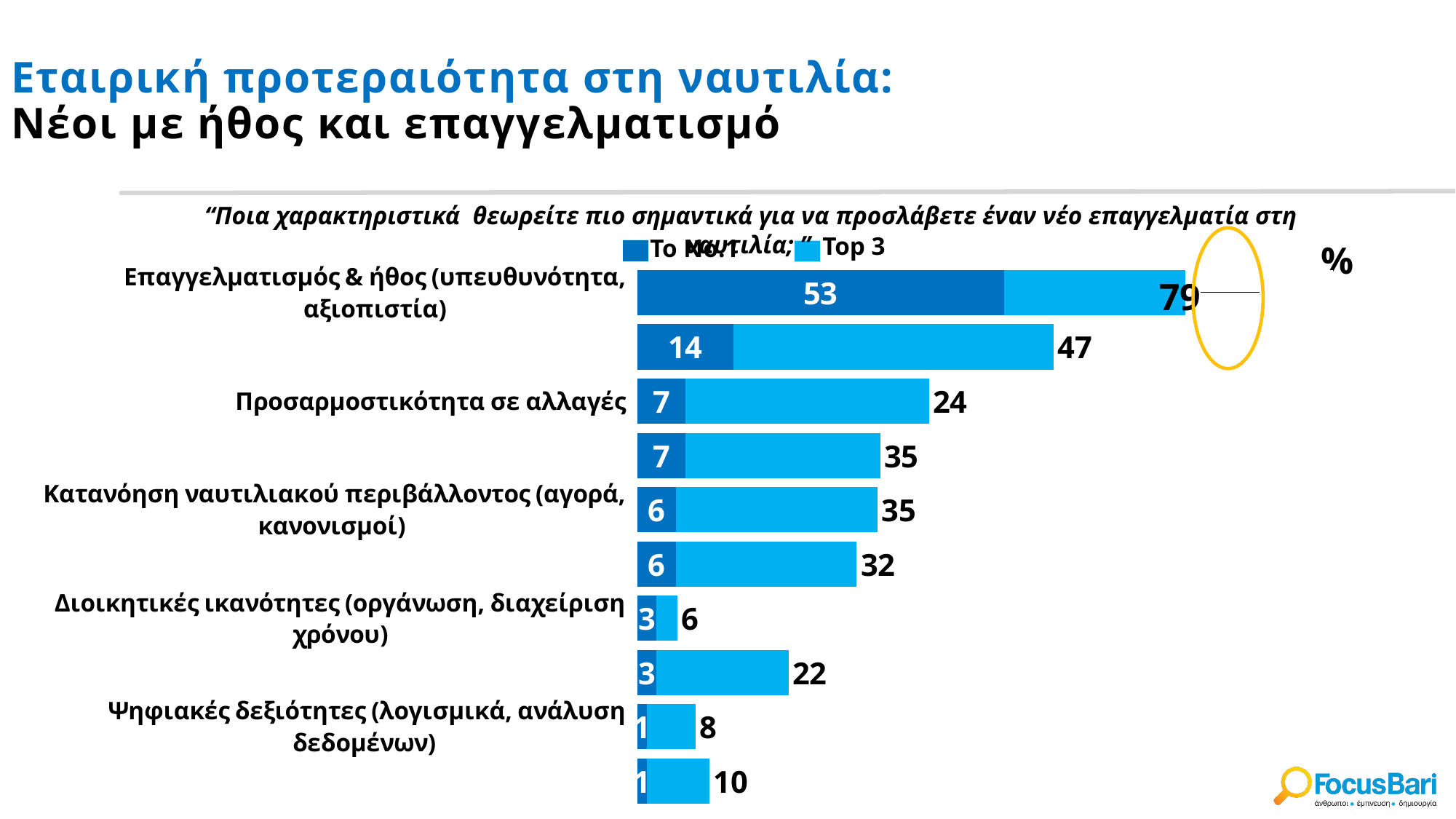
What is the difference between the Top 3 value and the "Το No.1" value for "Επαγγελματισμός & ήθος (υπευθυνότητα, αξιοπιστία)"? 26 What is the Top 3 value for "Προσαρμοστικότητα σε αλλαγές"? 24 Which has a larger Top 3 value: "Προσαρμοστικότητα σε αλλαγές" or "Κατανόηση ναυτιλιακού περιβάλλοντος (αγορά, κανονισμοί)"? Κατανόηση ναυτιλιακού περιβάλλοντος (αγορά, κανονισμοί) What is the "Το No.1" value for "Επαγγελματισμός & ήθος (υπευθυνότητα, αξιοπιστία)"? 53 Which category has the highest Top 3 value? Επαγγελματισμός & ήθος (υπευθυνότητα, αξιοπιστία) What is the "Το No.1" value for "Κατανόηση ναυτιλιακού περιβάλλοντος (αγορά, κανονισμοί)"? 6 What kind of chart is shown on the slide? Bar chart How many series does the legend list? 2 What is the Top 3 value for "Διοικητικές ικανότητες (οργάνωση, διαχείριση χρόνου)"? 6 What is the Top 3 value for "Ψηφιακές δεξιότητες (λογισμικά, ανάλυση δεδομένων)"? 8 What is the Top 3 value for "Επαγγελματισμός & ήθος (υπευθυνότητα, αξιοπιστία)"? 79 What are the two legend entries of the chart? Το No.1 and Top 3